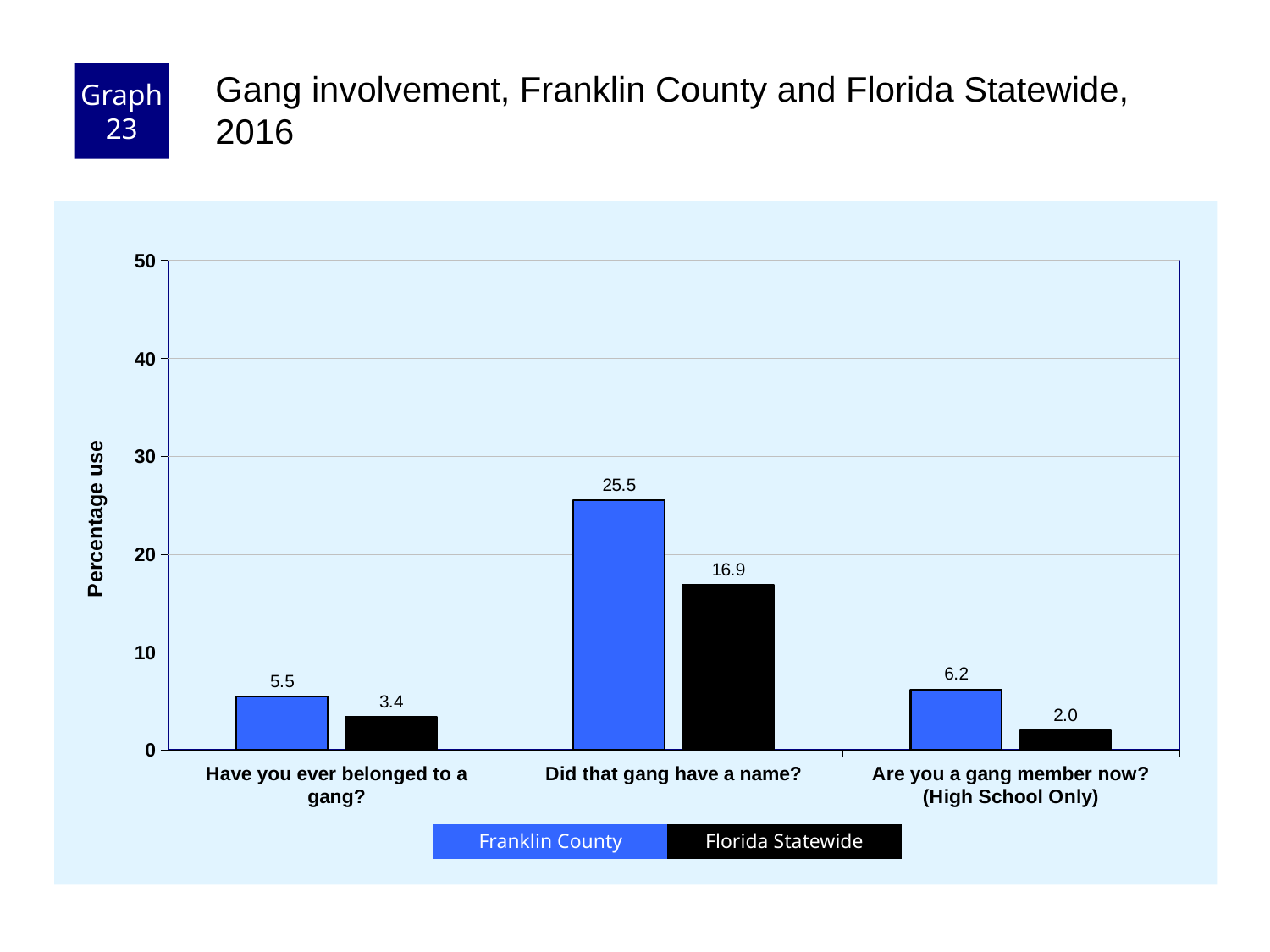
What kind of chart is shown on the slide? Bar chart What is the difference between the Franklin County and Florida Statewide values for "Did that gang have a name?"? 8.6 Which question has the lowest Florida Statewide value? Are you a gang member now? (High School Only) What is the Franklin County value for "Did that gang have a name?"? 25.5 What is the Florida Statewide value for "Have you ever belonged to a gang?"? 3.4 How many series does the legend list? 2 For "Are you a gang member now? (High School Only)", which is larger: Franklin County or Florida Statewide? Franklin County Which question has the highest Franklin County value? Did that gang have a name? What is the label of the y axis? Percentage use How many questions (categories) are shown on the x axis? 3 What is the Florida Statewide value for "Are you a gang member now? (High School Only)"? 2.0 Is the Florida Statewide value for "Did that gang have a name?" greater or less than 20? less